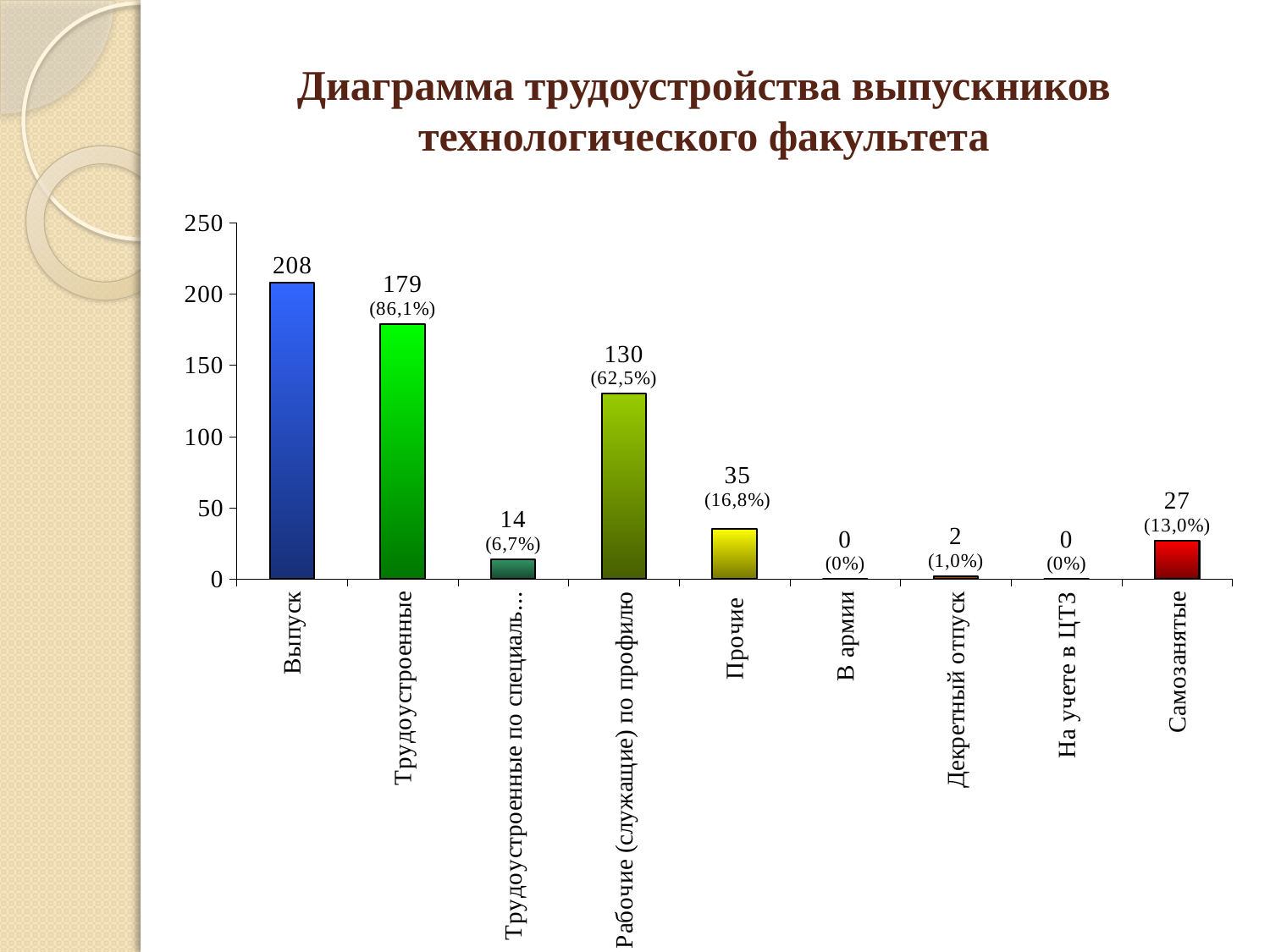
Which category has the highest value? Выпуск What kind of chart is shown on the slide? bar chart Is the value for Рабочие (служащие) по профилю greater or less than 100? greater What is the difference between the values for Выпуск and Трудоустроенные? 29 What is the value for Рабочие (служащие) по профилю? 130 Which is larger, the value for Прочие or the value for Самозанятые? Прочие What is the value for Выпуск? 208 What is the title of the chart? Диаграмма трудоустройства выпускников технологического факультета What is the value for Трудоустроенные? 179 How many categories are shown on the x axis? 9 What percentage is shown for Прочие? 16,8% What is the value for Самозанятые? 27